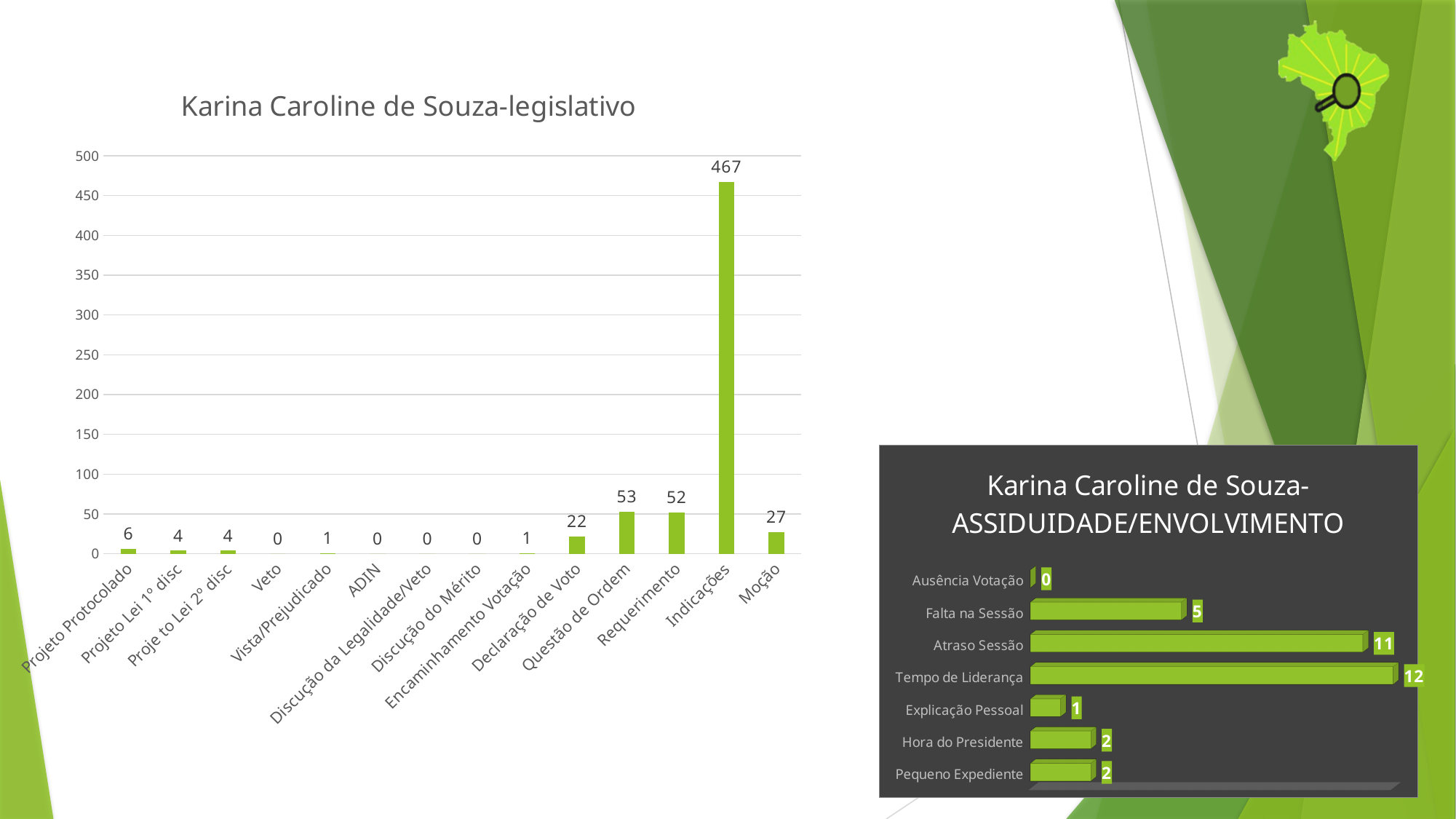
In the 'Karina Caroline de Souza-legislativo' chart, what is the difference between Questão de Ordem and Requerimento? 1 In the 'Karina Caroline de Souza-ASSIDUIDADE/ENVOLVIMENTO' chart, which category has the lowest value? Ausência Votação In the 'Karina Caroline de Souza-legislativo' chart, what is the value for Indicações? 467 How many categories are shown in the 'Karina Caroline de Souza-ASSIDUIDADE/ENVOLVIMENTO' chart? 7 How many categories are shown in the 'Karina Caroline de Souza-legislativo' chart? 14 In the 'Karina Caroline de Souza-legislativo' chart, which is larger, Moção or Declaração de Voto? Moção In the 'Karina Caroline de Souza-legislativo' chart, what is the value for Declaração de Voto? 22 What kind of chart is 'Karina Caroline de Souza-legislativo'? Bar chart In the 'Karina Caroline de Souza-ASSIDUIDADE/ENVOLVIMENTO' chart, what is the value for Atraso Sessão? 11 In the 'Karina Caroline de Souza-ASSIDUIDADE/ENVOLVIMENTO' chart, what is the difference between Tempo de Liderança and Falta na Sessão? 7 In the 'Karina Caroline de Souza-legislativo' chart, which category has the highest value? Indicações In the 'Karina Caroline de Souza-ASSIDUIDADE/ENVOLVIMENTO' chart, which category has the highest value? Tempo de Liderança